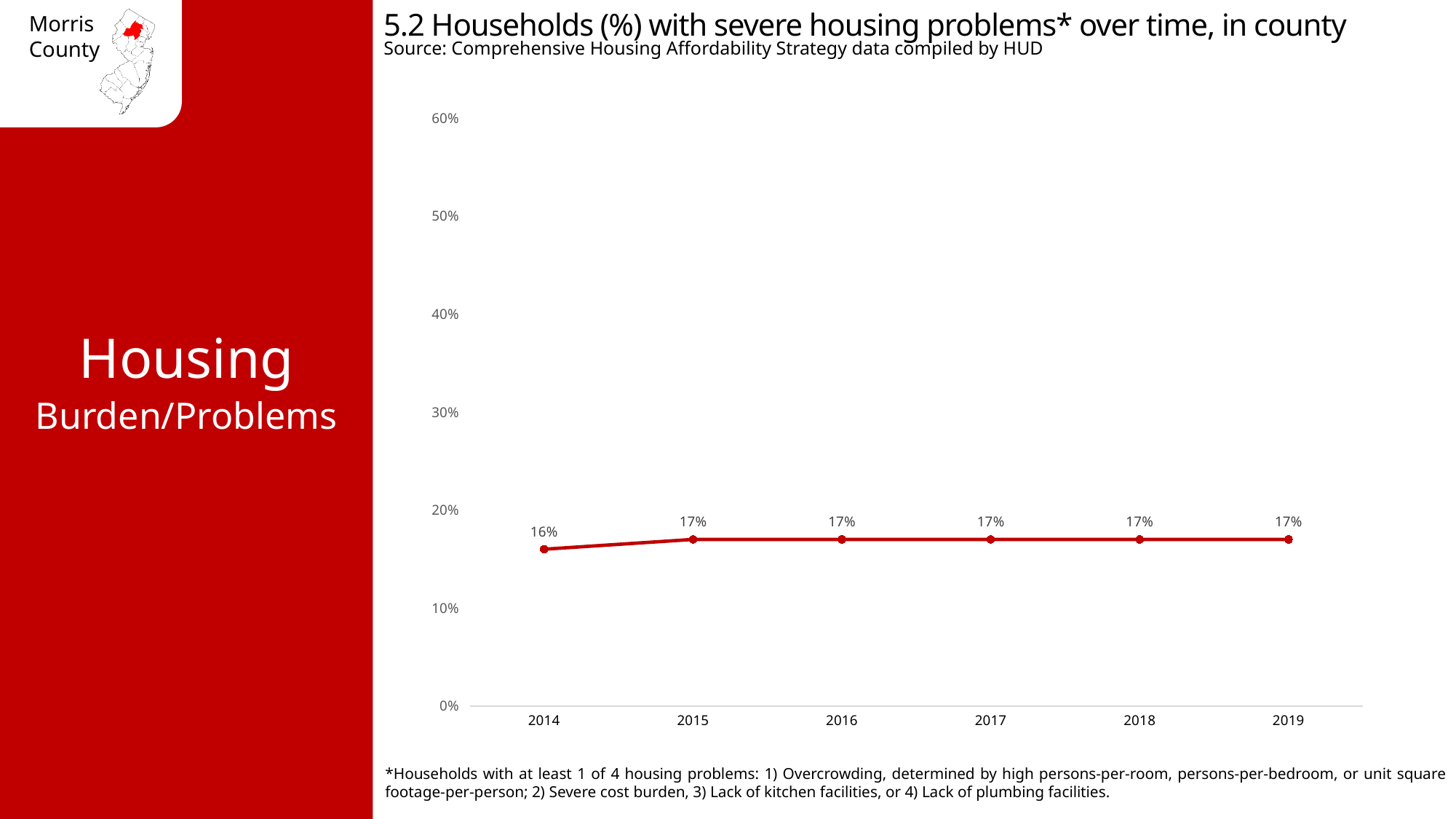
Is the value for 2017 greater or less than 20%? less What is the source of the data shown in the chart? Comprehensive Housing Affordability Strategy data compiled by HUD Which is larger, the value for 2014 or the value for 2018? 2018 What is the value shown for 2016? 17% Is the value for 2014 greater or less than 10%? greater What kind of chart is shown on the slide? line chart How many years are plotted on the chart? 6 Which year has the lowest percentage of households with severe housing problems? 2014 What percentage of households had severe housing problems in 2014? 16% What is the difference between the 2015 value and the 2014 value? 1% What percentage of households had severe housing problems in 2019? 17% Does the percentage of households with severe housing problems rise, fall, or stay flat from 2015 to 2019? stays flat